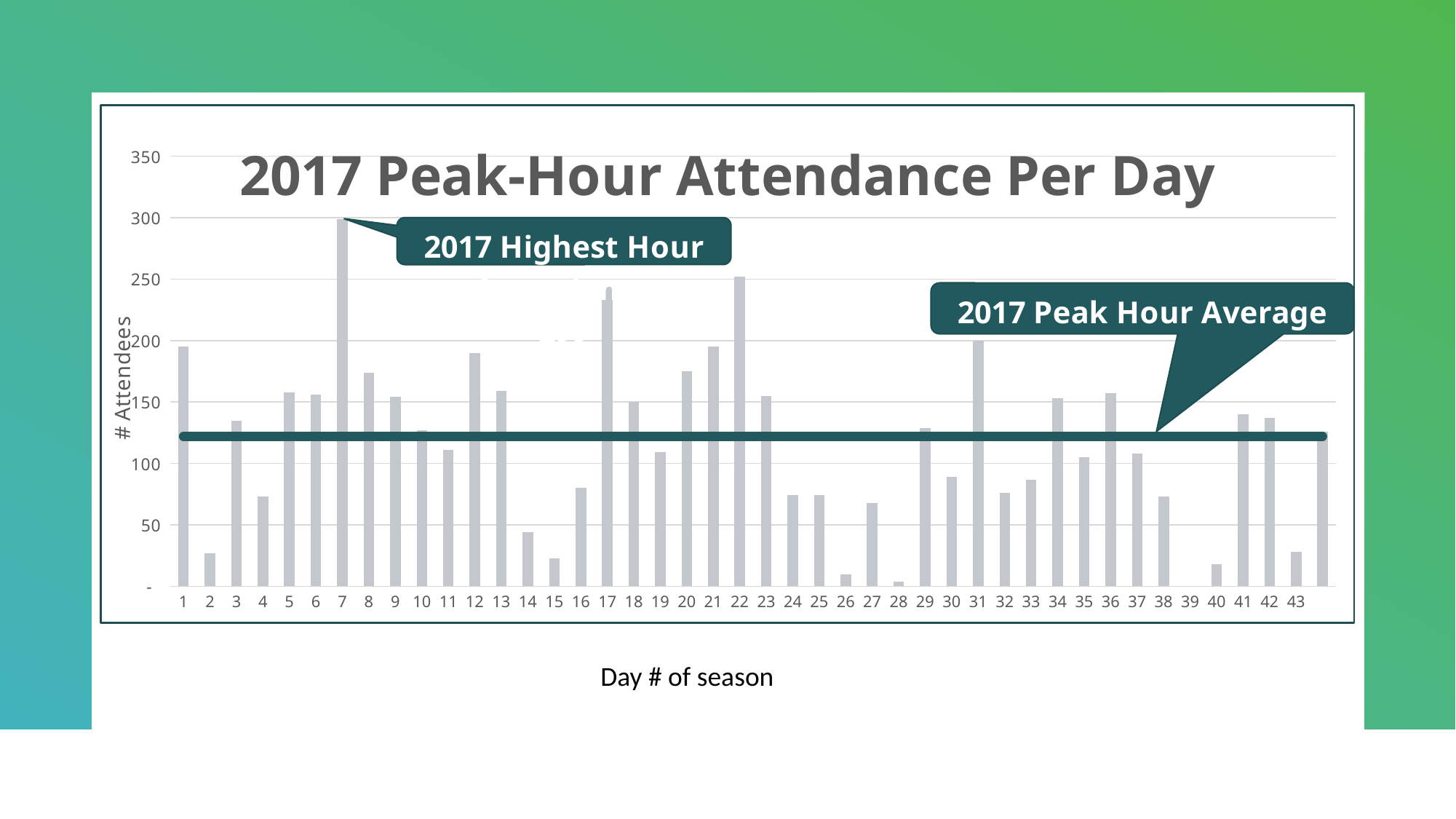
What type of chart is shown on the slide? Bar chart Which day of the season has the highest peak-hour attendance? Day 7 What does the horizontal line across the chart represent, according to its callout label? 2017 Peak Hour Average Which day of the season has the lowest peak-hour attendance? Day 28 What is the title of the chart? 2017 Peak-Hour Attendance Per Day Which has a higher peak-hour attendance, day 7 or day 22? Day 7 Which has a higher peak-hour attendance, day 17 or day 18? Day 17 Is the value for day 7 greater or less than 250? greater Is the value for day 17 greater or less than 200? greater Is the value for day 26 greater or less than 50? less